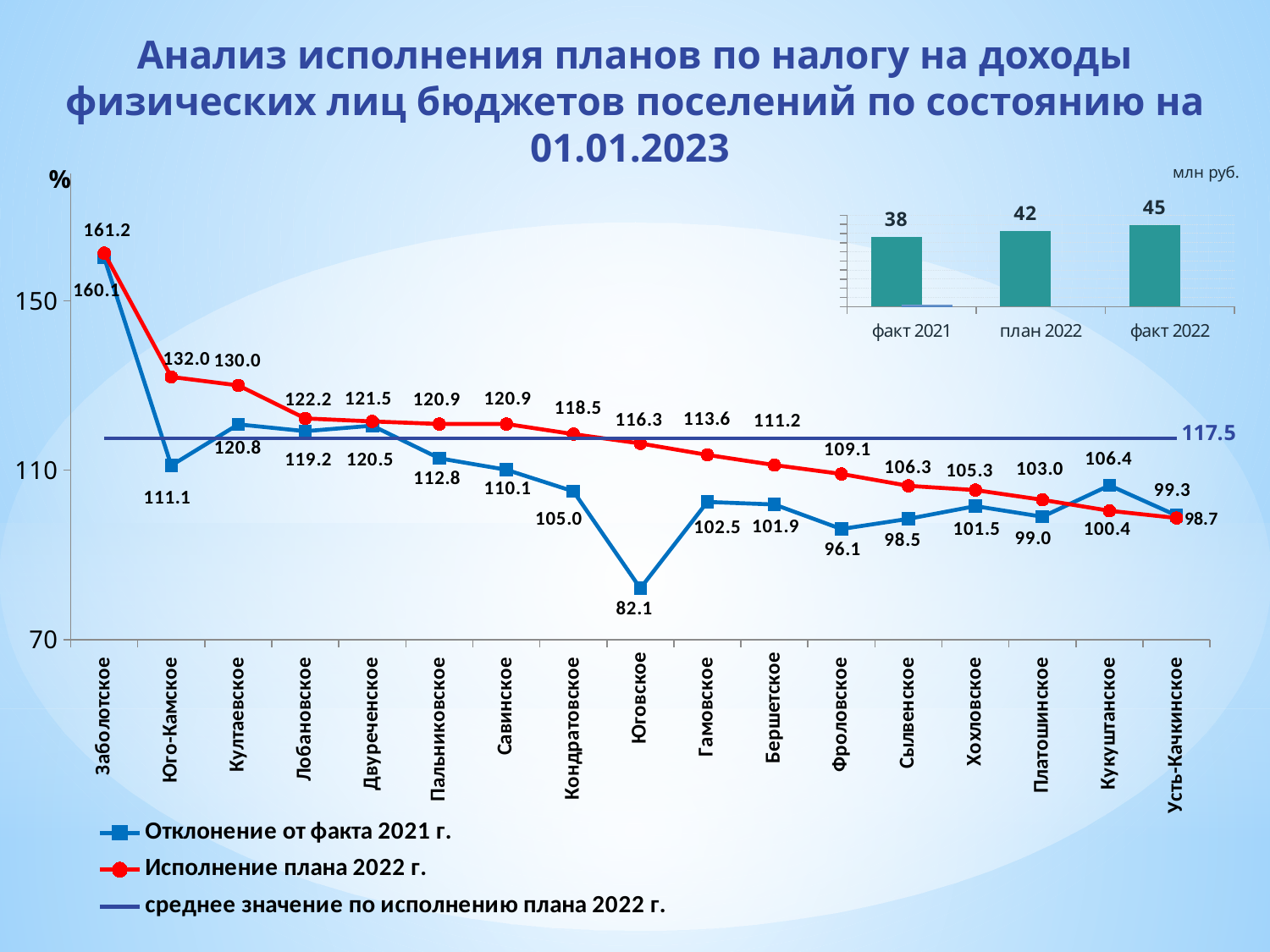
On the small bar chart in the top right, what is the value for факт 2022? 45 On the main line chart, which is larger for Кукуштанское: Отклонение от факта 2021 г. or Исполнение плана 2022 г.? Отклонение от факта 2021 г. On the small bar chart in the top right, what is the difference between план 2022 and факт 2021? 4 On the main line chart, what is the value of the среднее значение по исполнению плана 2022 г. line? 117.5 On the main line chart, which settlement has the lowest value for Отклонение от факта 2021 г.? Юговское On the main line chart, what is the value of Исполнение плана 2022 г. for Юго-Камское? 132.0 On the main line chart, what is the value of Отклонение от факта 2021 г. for Юговское? 82.1 On the small bar chart in the top right, do the values rise or fall from left to right? rise On the main line chart, what is the difference between Исполнение плана 2022 г. and Отклонение от факта 2021 г. for Юго-Камское? 20.9 On the main line chart, how many settlements are shown on the x axis? 17 On the small bar chart in the top right, which category has the lowest value? факт 2021 On the main line chart, which settlement has the highest value for Исполнение плана 2022 г.? Заболотское